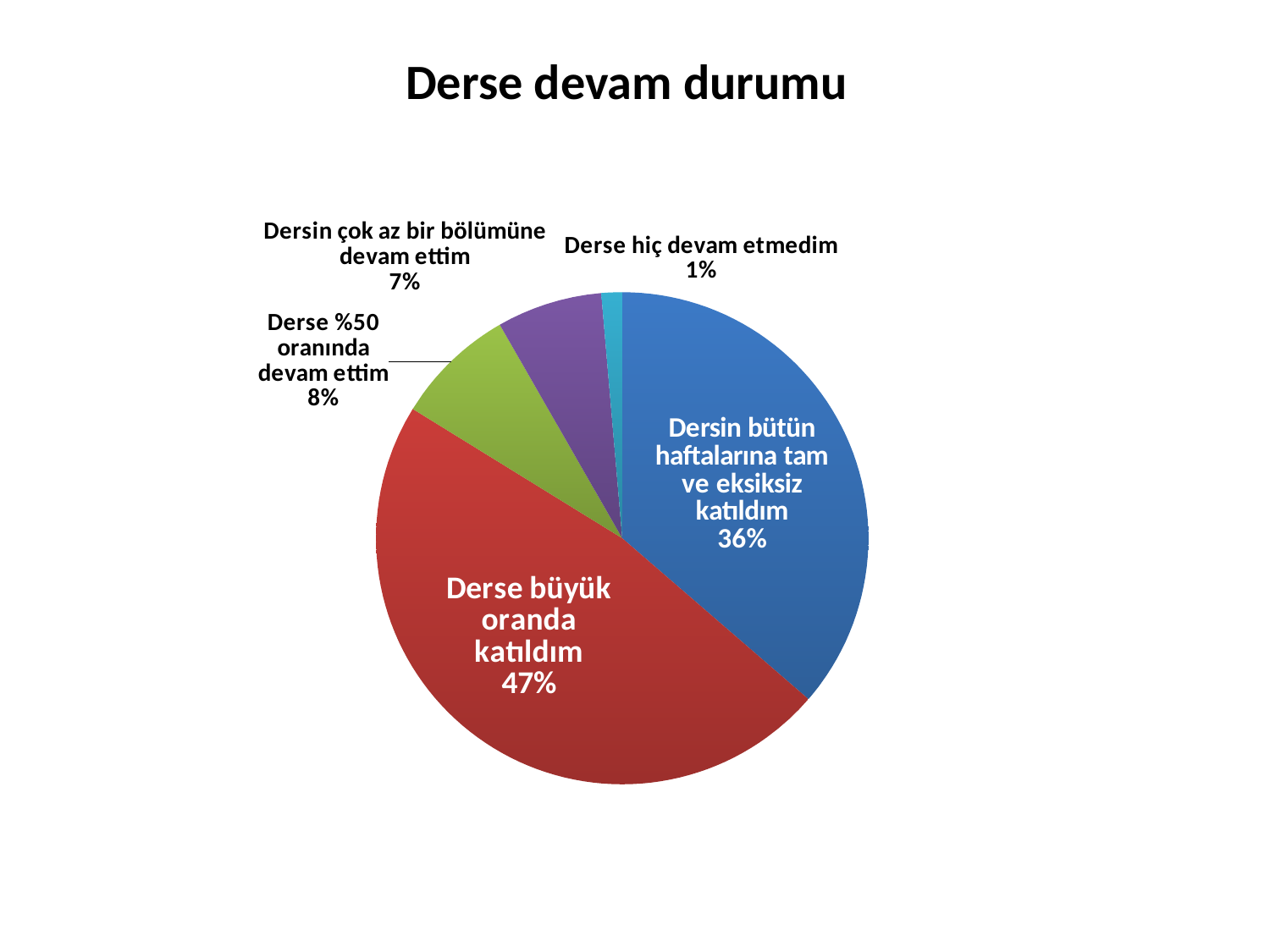
Which is larger: the share for "Derse %50 oranında devam ettim" or the share for "Dersin çok az bir bölümüne devam ettim"? Derse %50 oranında devam ettim What share of the pie is labelled "Dersin çok az bir bölümüne devam ettim"? 7% How many slices does the pie chart have? 5 Which slice of the pie is the largest? Derse büyük oranda katıldım Which slice of the pie is the smallest? Derse hiç devam etmedim What is the title of the chart? Derse devam durumu What share of the pie is labelled "Derse hiç devam etmedim"? 1% What kind of chart is shown on the slide? pie chart What is the difference in percentage points between "Derse büyük oranda katıldım" and "Dersin bütün haftalarına tam ve eksiksiz katıldım"? 11% What share of the pie is labelled "Derse %50 oranında devam ettim"? 8%